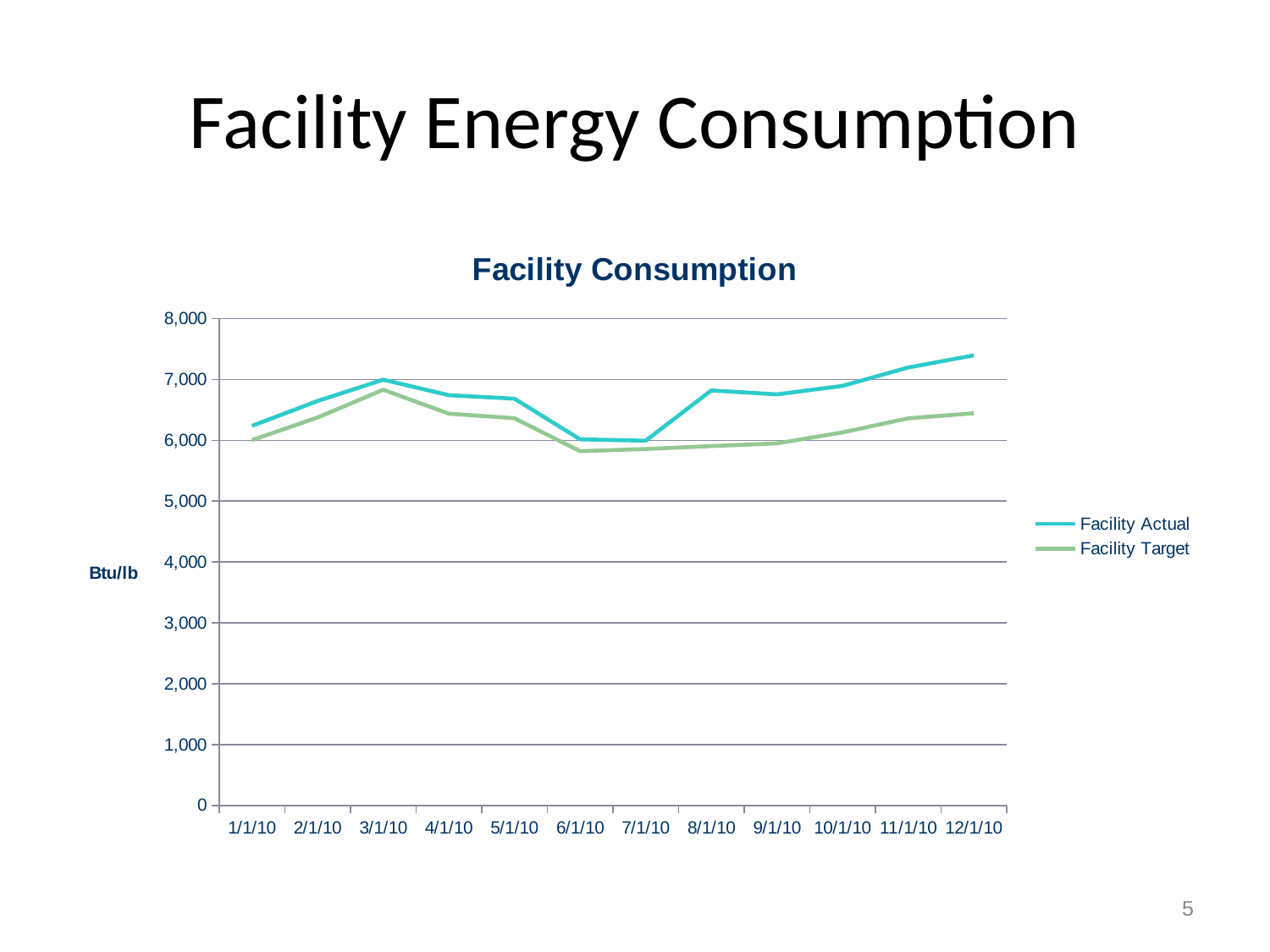
How many series does the legend list? 2 How many dates are plotted along the x axis? 12 Does Facility Actual rise or fall from 8/1/10 to 12/1/10? rise Is the Facility Target value for 6/1/10 greater or less than 6,000? less Is the Facility Actual value for 12/1/10 greater or less than 7,000? greater Is the Facility Target value for 12/1/10 greater or less than 6,000? greater At 8/1/10, which is higher: Facility Actual or Facility Target? Facility Actual On which date is Facility Target at its highest? 3/1/10 On which date is Facility Actual at its highest? 12/1/10 What kind of chart is shown on the slide? line chart What is the label on the vertical axis of the chart? Btu/lb